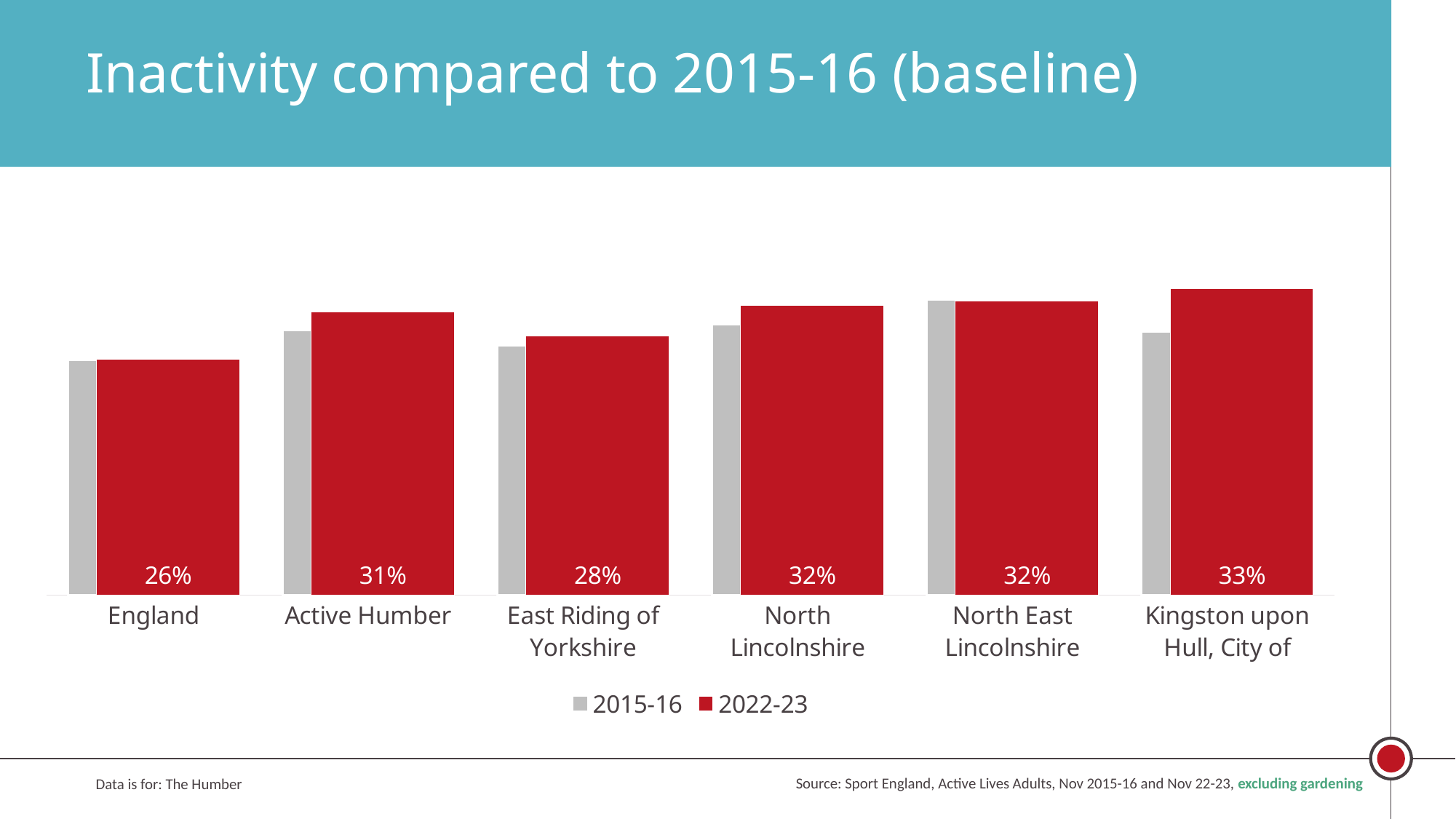
How many series does the legend list? 2 What is the 2022-23 inactivity value for England? 26% Which category has the lowest 2022-23 inactivity value? England What is the 2022-23 inactivity value for East Riding of Yorkshire? 28% What kind of chart is shown on the slide? Bar chart Which has the larger 2022-23 value, Active Humber or East Riding of Yorkshire? Active Humber Which category has the highest 2022-23 inactivity value? Kingston upon Hull, City of What is the 2022-23 inactivity value for Kingston upon Hull, City of? 33% For Kingston upon Hull, City of, which bar is taller, 2015-16 or 2022-23? 2022-23 What is the 2022-23 inactivity value for Active Humber? 31% What is the difference between the 2022-23 values for Kingston upon Hull, City of and England? 7 percentage points How many categories are shown on the x axis? 6